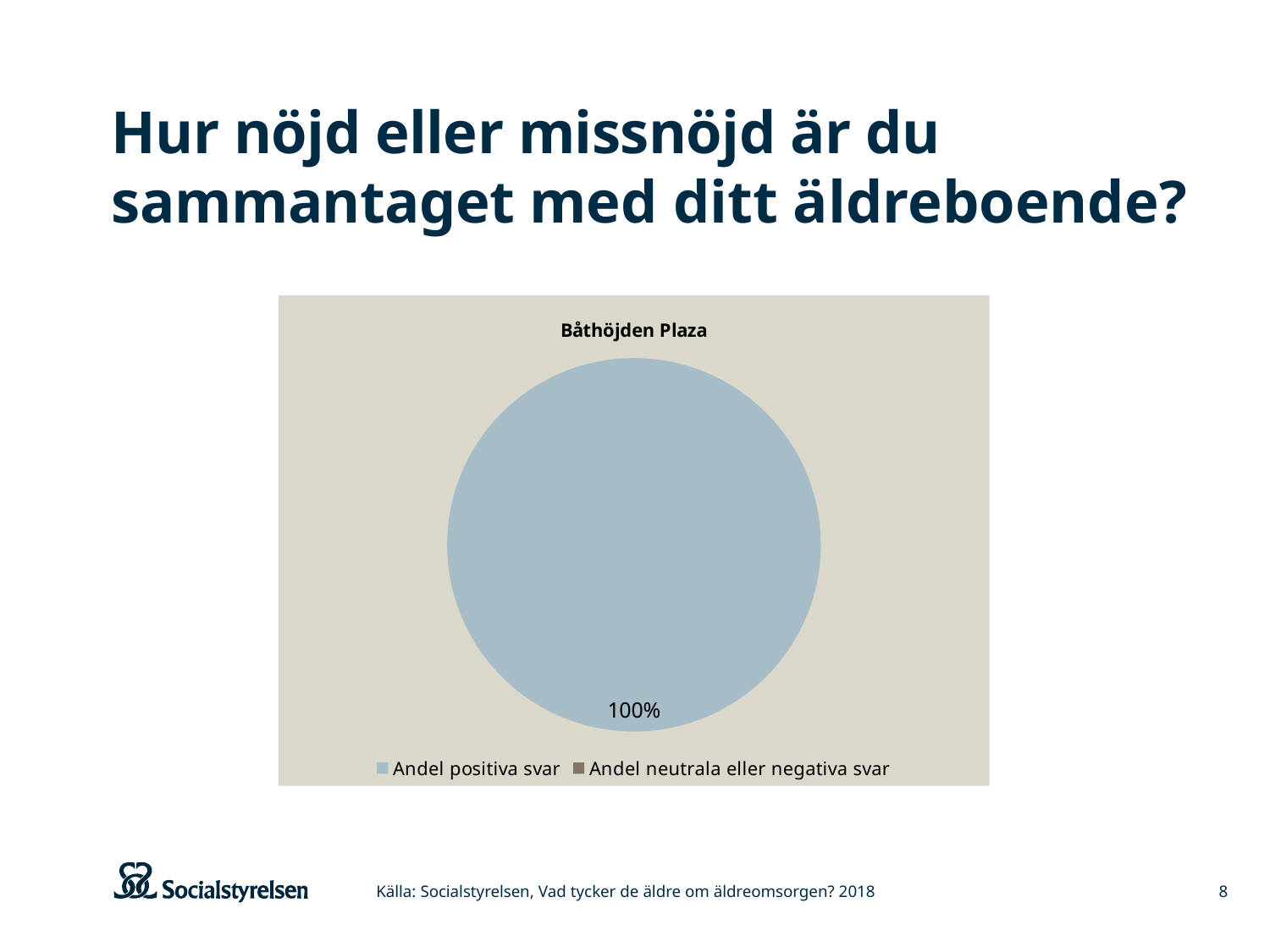
What is the title of the chart? Båthöjden Plaza What value is printed on the pie slice? 100% What is the second entry listed in the legend? Andel neutrala eller negativa svar Which is larger, the share for "Andel positiva svar" or the share for "Andel neutrala eller negativa svar"? Andel positiva svar Which legend entry has the smallest share of the pie? Andel neutrala eller negativa svar Which legend entry has the largest share of the pie? Andel positiva svar How many entries does the legend list? 2 What kind of chart is shown on the slide? pie chart Is the share for "Andel positiva svar" greater or less than 50%? greater What share of the pie does "Andel positiva svar" take? 100%